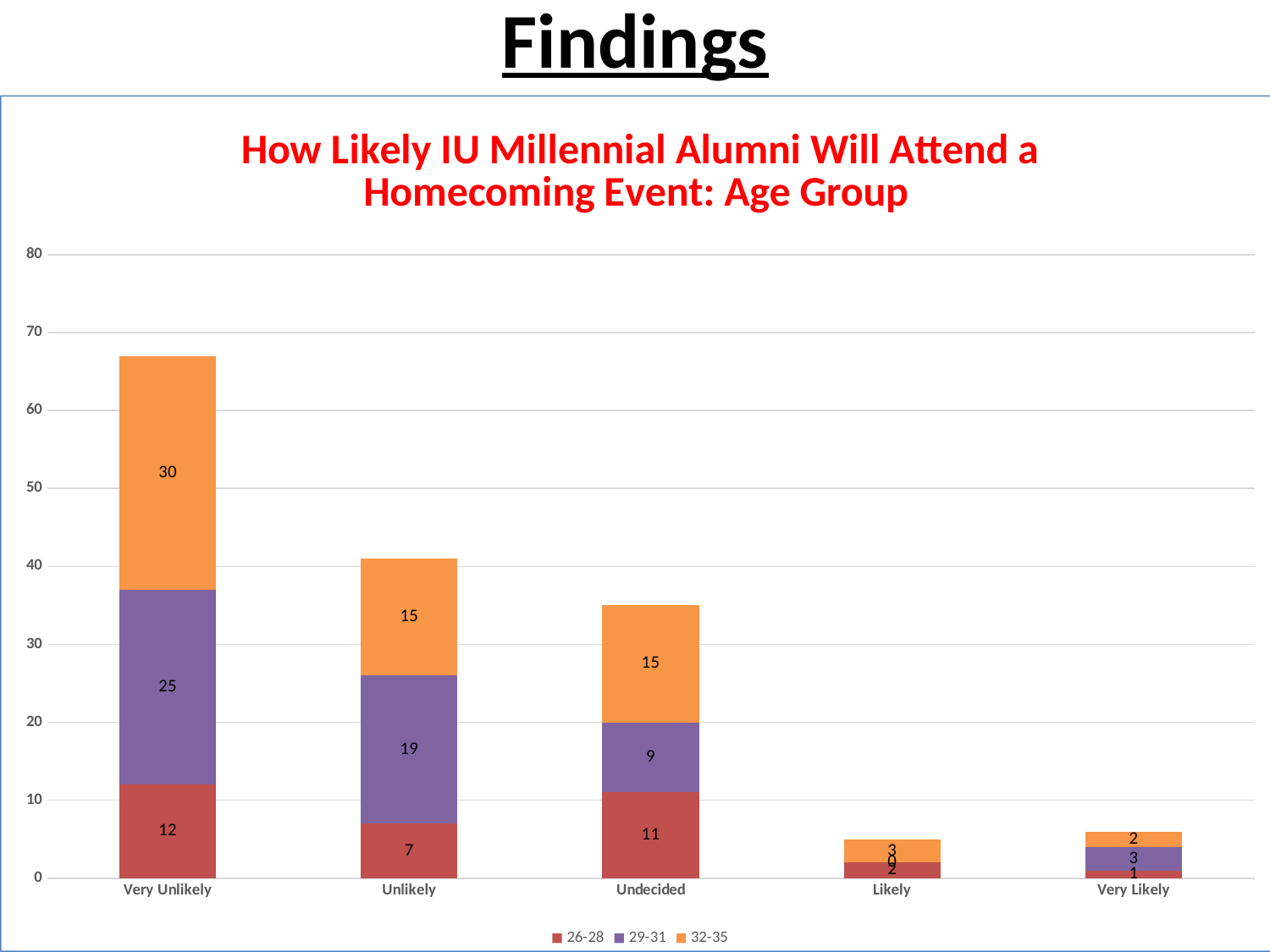
How many series does the legend list? 3 What type of chart is shown on the slide? Stacked bar chart What is the value for the 29-31 age group in the Unlikely category? 19 What is the value for the 32-35 age group in the Very Unlikely category? 30 What is the value for the 26-28 age group in the Undecided category? 11 What is the total of the stacked bar for Very Unlikely? 67 Which is larger: the 32-35 value for Unlikely or the 26-28 value for Unlikely? 32-35 value for Unlikely What is the difference between the 29-31 values for Very Unlikely and Undecided? 16 What is the total of the stacked bar for Undecided? 35 How many categories are shown on the x axis? 5 What is the value for the 29-31 age group in the Very Likely category? 3 Which category has the tallest stacked bar? Very Unlikely